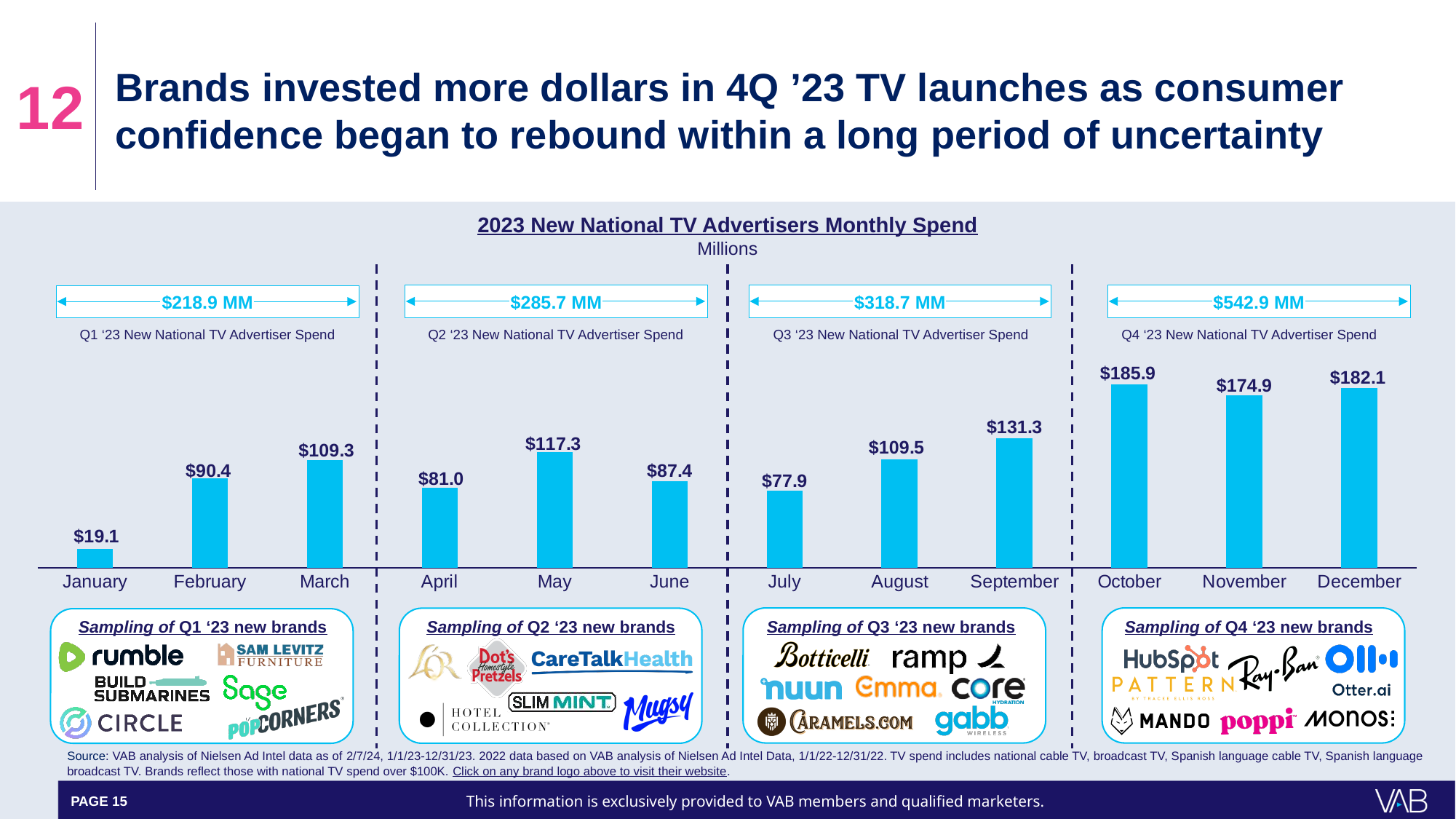
Which month has the highest spend? October What is the difference between the December and November values? $7.2 What kind of chart is shown on the slide? Bar chart Which is larger, the value for May or the value for June? May What is the value shown for January? $19.1 Which month has the lowest spend? January Do the values rise or fall from January to March? Rise What is the value shown for September? $131.3 How many months are plotted on the chart? 12 What is the total Q4 '23 new national TV advertiser spend shown on the chart? $542.9 MM What is the new national TV advertiser spend for October? $185.9 What is the difference between the September and July values? $53.4